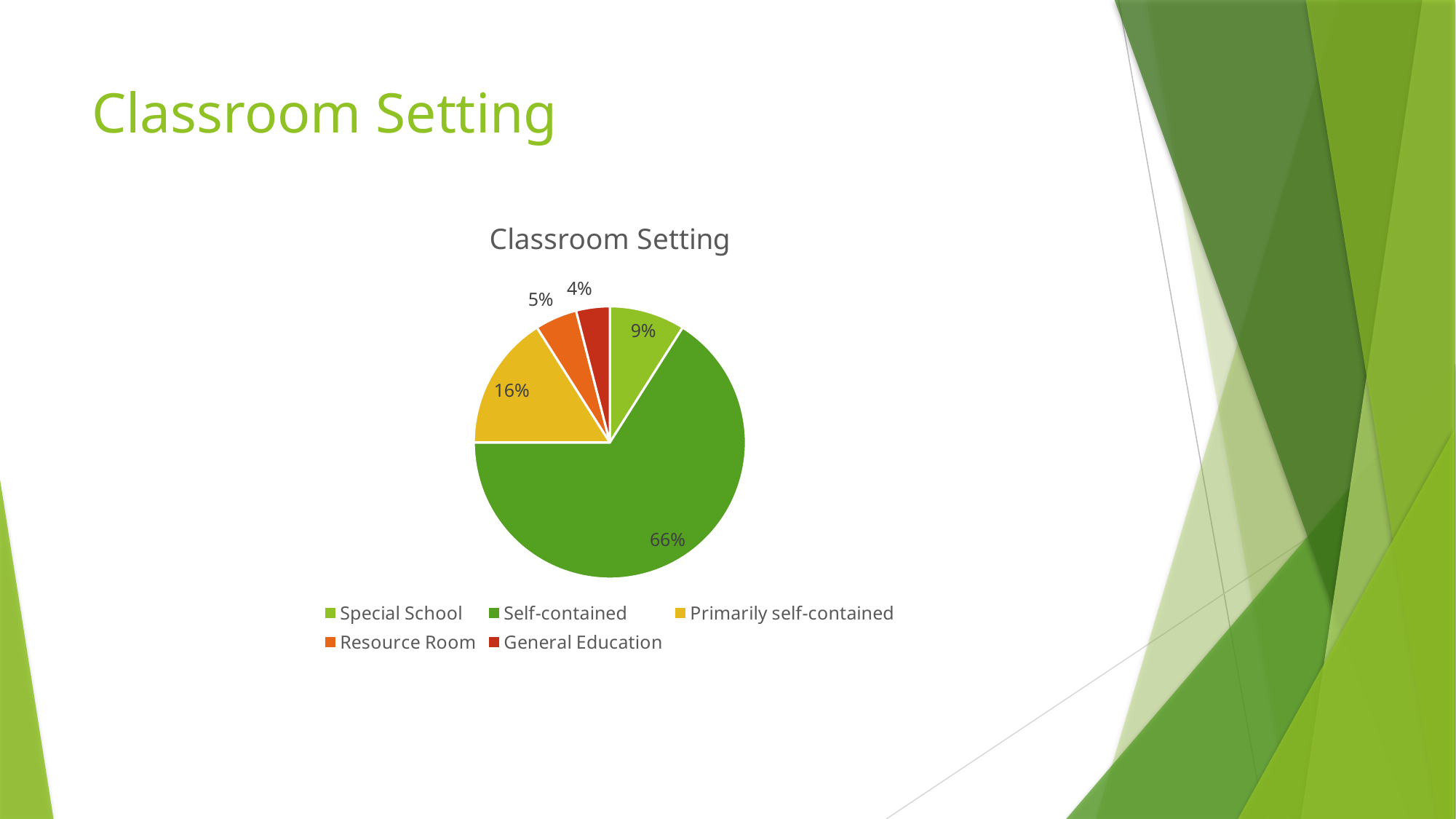
Which category has the largest share of the pie? Self-contained Which is larger, the share for Special School or the share for Resource Room? Special School What type of chart is shown on the slide? pie chart How many categories does the pie chart have? 5 What percentage of the pie is Resource Room? 5% What percentage of the pie is Special School? 9% Which category has the smallest share of the pie? General Education What is the title of the chart? Classroom Setting What percentage of the pie is Self-contained? 66% What percentage of the pie is Primarily self-contained? 16% What is the difference in percentage points between Self-contained and Primarily self-contained? 50 What percentage of the pie is General Education? 4%